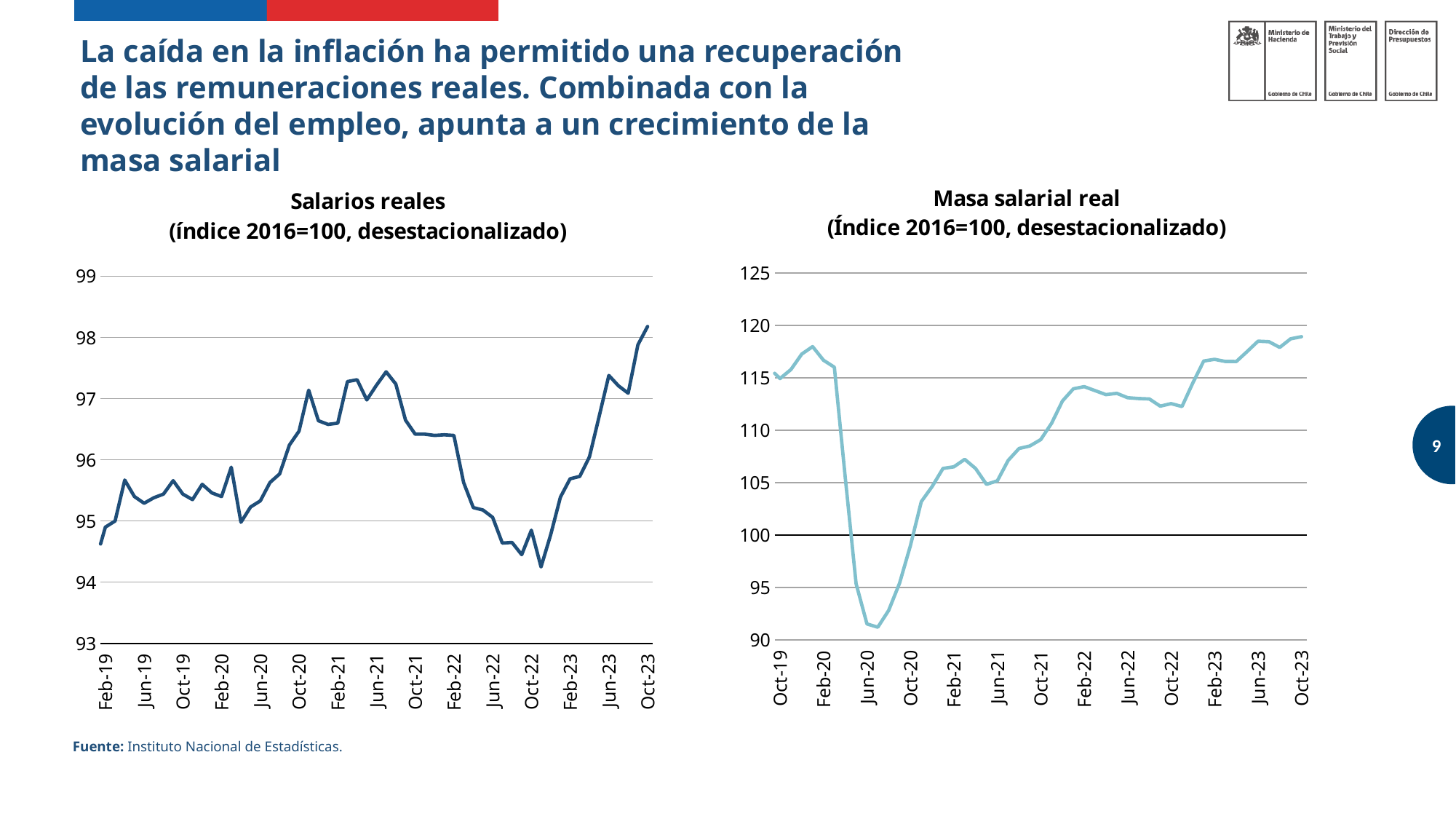
In the 'Masa salarial real' chart, is the value for Oct-23 greater or less than 115? greater What is the base year of the index used in both charts? 2016=100 What kind of chart is the 'Salarios reales' chart on the left? line chart In the 'Masa salarial real' chart, which is larger, the value for Oct-19 or the value for Oct-23? Oct-23 In the 'Salarios reales' chart, which date shows the highest value? Oct-23 In the 'Masa salarial real' chart, does the series rise or fall between Jun-20 and Feb-22? rise In the 'Masa salarial real' chart, is the value for Jun-20 greater or less than 95? less What kind of chart is the 'Masa salarial real' chart on the right? line chart In the 'Salarios reales' chart, is the value for Oct-23 greater or less than 98? greater In the 'Masa salarial real' chart, around which date does the series reach its lowest value? Jun-20